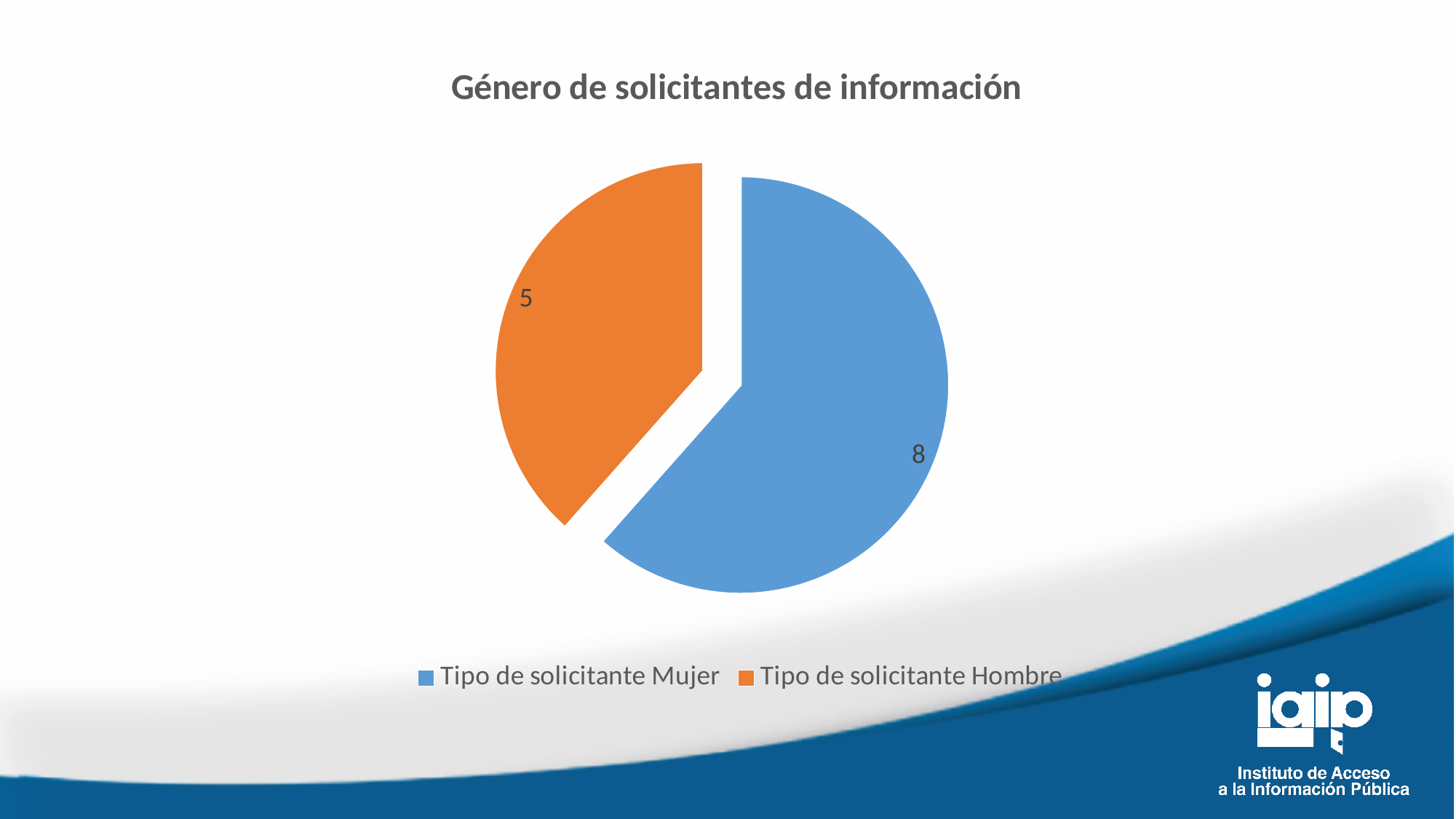
What is the title of the chart? Género de solicitantes de información What is the value for Tipo de solicitante Hombre? 5 What colour is the slice for Tipo de solicitante Hombre? Orange How many entries does the legend list? 2 Which category has the largest slice? Tipo de solicitante Mujer What is the total of all slices in the pie chart? 13 What is the value for Tipo de solicitante Mujer? 8 Which is larger, the value for Tipo de solicitante Mujer or Tipo de solicitante Hombre? Tipo de solicitante Mujer How many slices does the pie chart have? 2 Which category has the smallest slice? Tipo de solicitante Hombre What is the difference between the values for Tipo de solicitante Mujer and Tipo de solicitante Hombre? 3 What kind of chart is shown on the slide? Pie chart